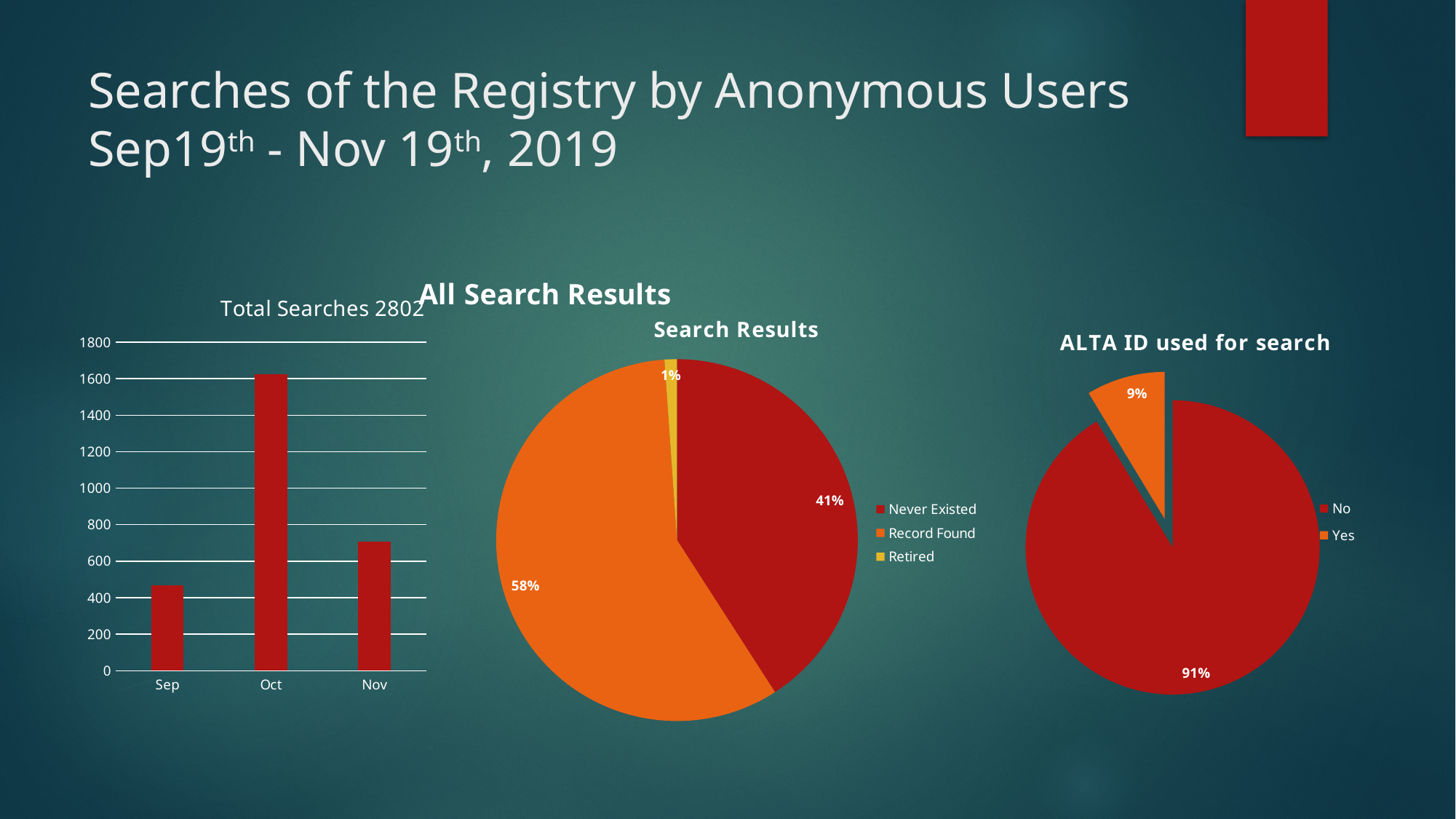
In the 'Total Searches 2802' bar chart, is the value for Oct greater or less than 1400? greater In the 'Search Results' pie chart, which category has the smallest slice? Retired In the 'Search Results' pie chart, what share is labelled for Never Existed? 41% In the 'ALTA ID used for search' pie chart, what is the difference between the No share and the Yes share? 82% What kind of chart is the 'Total Searches 2802' chart? Bar chart How many months are shown in the 'Total Searches 2802' bar chart? 3 How many entries does the legend of the 'Search Results' pie chart list? 3 In the 'Total Searches 2802' bar chart, which month has the lowest value? Sep In the 'Total Searches 2802' bar chart, which month has the highest value? Oct In the 'Total Searches 2802' bar chart, is the value for Sep greater or less than 600? less In the 'Search Results' pie chart, what share is labelled for Record Found? 58% In the 'Total Searches 2802' bar chart, is the value for Nov greater or less than 600? greater